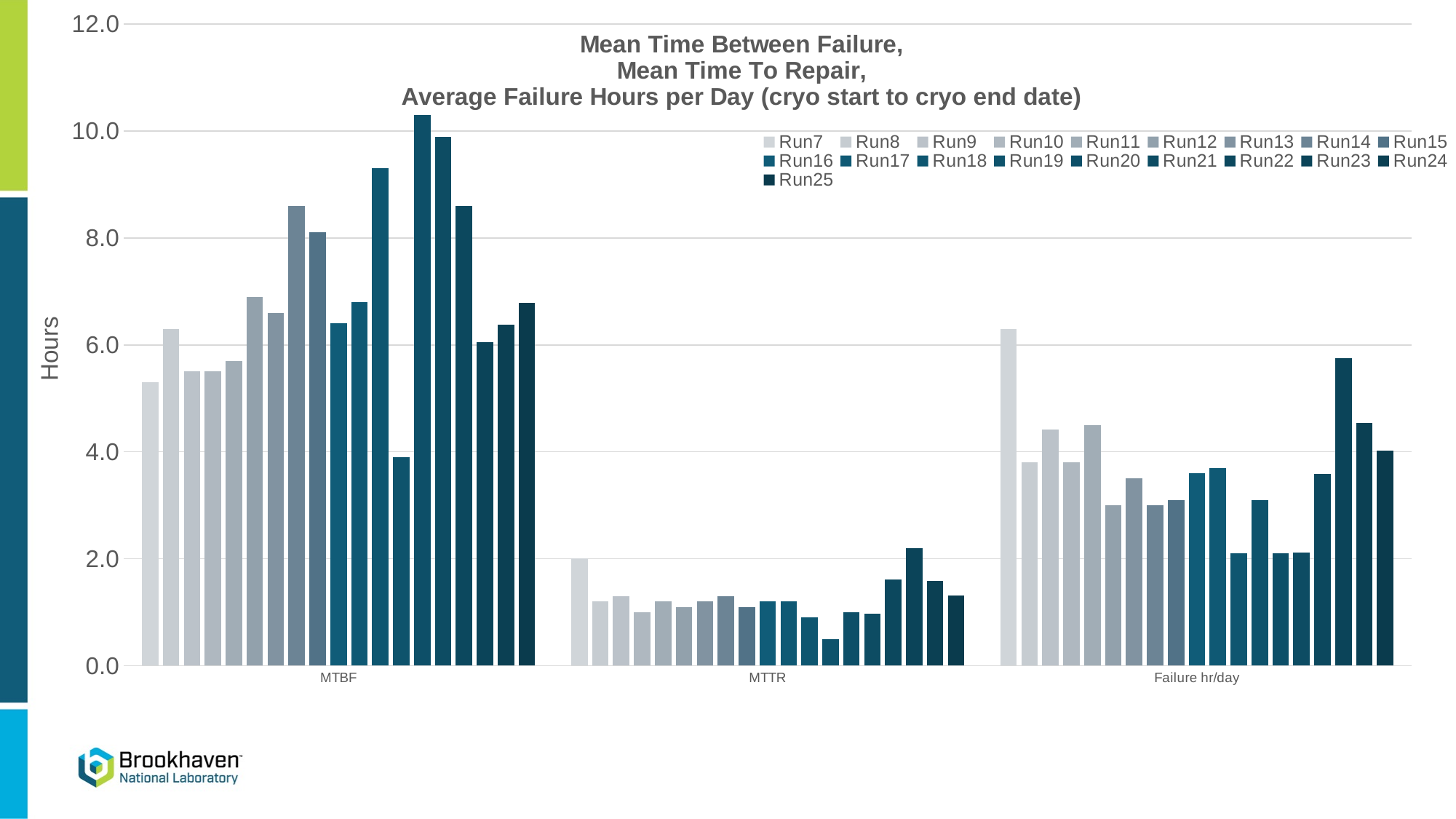
How many categories are shown along the x axis? 3 Which run has the highest Failure hr/day value? Run7 Which run has the lowest MTTR value? Run19 What kind of chart is shown on the slide? bar chart Is the MTBF value for Run18 greater or less than 8.0? greater Is the MTBF value for Run19 greater or less than 6.0? less What is the label on the vertical axis? Hours How many series does the legend list? 19 Which run has the lowest MTBF value? Run19 For Failure hr/day, which is larger: Run7 or Run8? Run7 Which run has the highest MTBF value? Run20